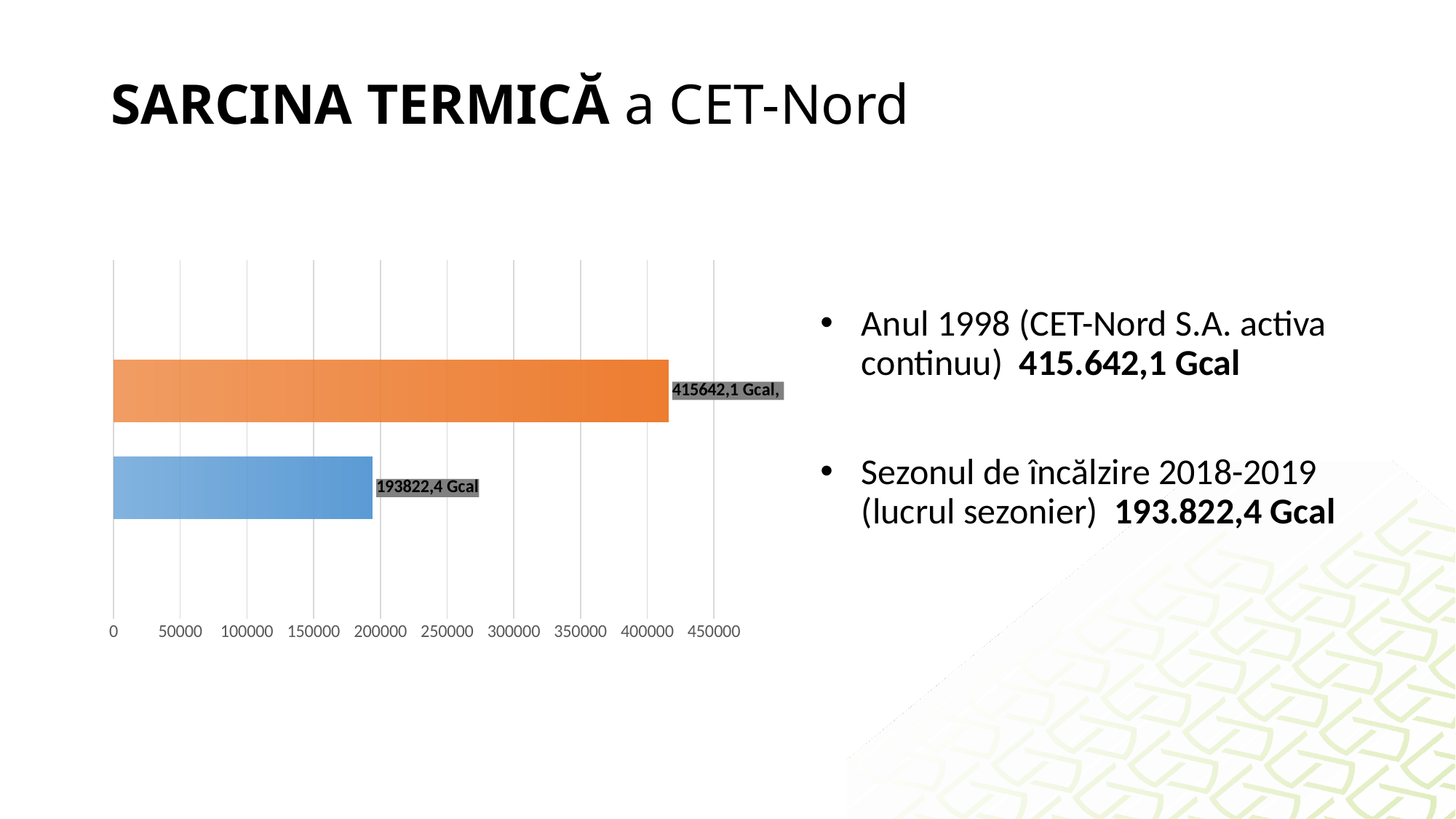
What is the lowest value among the plotted bars? 193822,4 Gcal How many bars are plotted in the chart? 2 What is the title of the slide containing the chart? SARCINA TERMICĂ a CET-Nord What value is labelled on the orange (top) bar? 415642,1 Gcal What is the difference between the orange bar's value and the blue bar's value? 221819,7 Gcal Is the value of the orange bar greater or less than 400000? greater What type of chart is shown on the slide? bar chart What value is labelled on the blue (bottom) bar? 193822,4 Gcal Is the value of the blue bar greater or less than 200000? less What is the highest tick value shown on the horizontal axis? 450000 Which bar has the higher value, the orange one or the blue one? the orange one What is the highest value among the plotted bars? 415642,1 Gcal